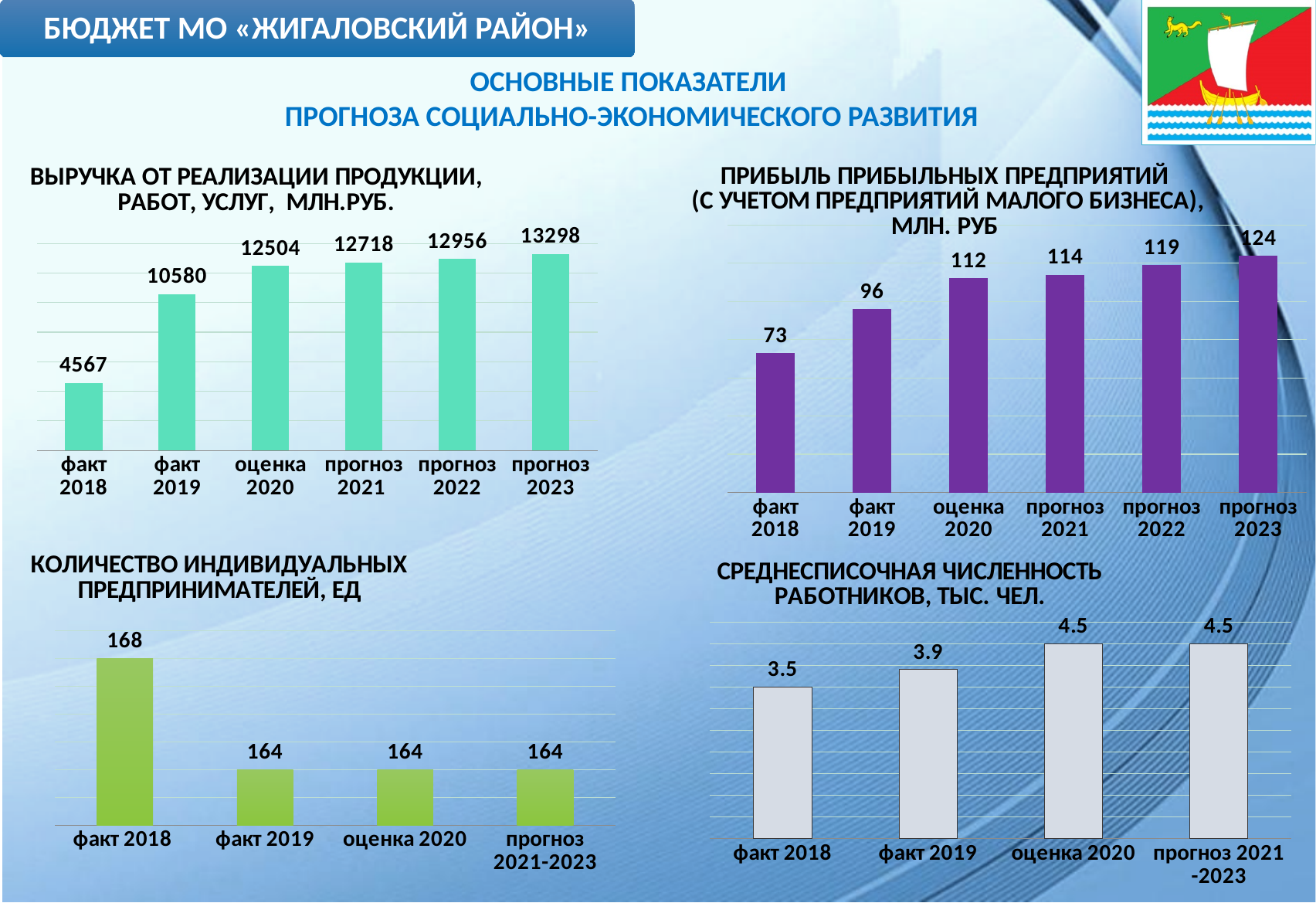
In the chart 'КОЛИЧЕСТВО ИНДИВИДУАЛЬНЫХ ПРЕДПРИНИМАТЕЛЕЙ, ЕД', which is larger: факт 2018 or оценка 2020? факт 2018 In the chart 'ПРИБЫЛЬ ПРИБЫЛЬНЫХ ПРЕДПРИЯТИЙ (С УЧЕТОМ ПРЕДПРИЯТИЙ МАЛОГО БИЗНЕСА), МЛН. РУБ', what is the value for оценка 2020? 112 In the chart 'СРЕДНЕСПИСОЧНАЯ ЧИСЛЕННОСТЬ РАБОТНИКОВ, ТЫС. ЧЕЛ.', what is the value for факт 2019? 3.9 What kind of chart is 'СРЕДНЕСПИСОЧНАЯ ЧИСЛЕННОСТЬ РАБОТНИКОВ, ТЫС. ЧЕЛ.'? bar chart In the chart 'ВЫРУЧКА ОТ РЕАЛИЗАЦИИ ПРОДУКЦИИ, РАБОТ, УСЛУГ, МЛН.РУБ.', which category has the lowest value? факт 2018 In the chart 'ВЫРУЧКА ОТ РЕАЛИЗАЦИИ ПРОДУКЦИИ, РАБОТ, УСЛУГ, МЛН.РУБ.', what is the difference between прогноз 2023 and оценка 2020? 794 In the chart 'ПРИБЫЛЬ ПРИБЫЛЬНЫХ ПРЕДПРИЯТИЙ (С УЧЕТОМ ПРЕДПРИЯТИЙ МАЛОГО БИЗНЕСА), МЛН. РУБ', how many categories are shown? 6 In the chart 'ВЫРУЧКА ОТ РЕАЛИЗАЦИИ ПРОДУКЦИИ, РАБОТ, УСЛУГ, МЛН.РУБ.', what is the value for факт 2019? 10580 In the chart 'ВЫРУЧКА ОТ РЕАЛИЗАЦИИ ПРОДУКЦИИ, РАБОТ, УСЛУГ, МЛН.РУБ.', do the values rise or fall from факт 2018 to прогноз 2023? rise In the chart 'КОЛИЧЕСТВО ИНДИВИДУАЛЬНЫХ ПРЕДПРИНИМАТЕЛЕЙ, ЕД', what is the value for факт 2018? 168 In the chart 'ПРИБЫЛЬ ПРИБЫЛЬНЫХ ПРЕДПРИЯТИЙ (С УЧЕТОМ ПРЕДПРИЯТИЙ МАЛОГО БИЗНЕСА), МЛН. РУБ', what is the difference between факт 2019 and факт 2018? 23 In the chart 'ПРИБЫЛЬ ПРИБЫЛЬНЫХ ПРЕДПРИЯТИЙ (С УЧЕТОМ ПРЕДПРИЯТИЙ МАЛОГО БИЗНЕСА), МЛН. РУБ', which category has the highest value? прогноз 2023